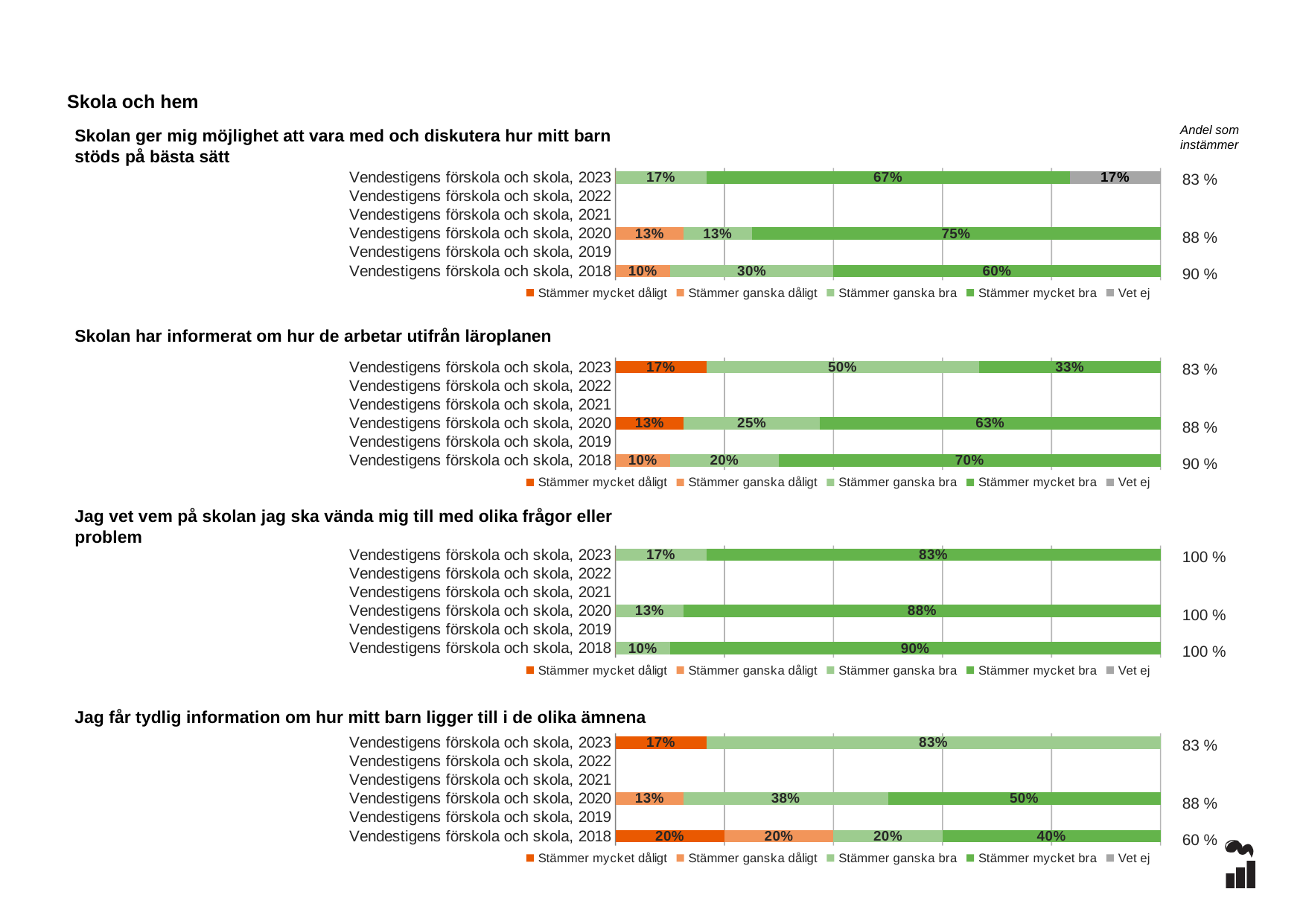
In the chart 'Jag får tydlig information om hur mitt barn ligger till i de olika ämnena', what is the 'Stämmer ganska bra' value for Vendestigens förskola och skola, 2020? 38% In the chart 'Jag vet vem på skolan jag ska vända mig till med olika frågor eller problem', what is the 'Stämmer mycket bra' value for Vendestigens förskola och skola, 2018? 90% In the chart 'Skolan har informerat om hur de arbetar utifrån läroplanen', what is the 'Stämmer ganska bra' value for Vendestigens förskola och skola, 2023? 50% In the chart 'Skolan ger mig möjlighet att vara med och diskutera hur mitt barn stöds på bästa sätt', what is the 'Vet ej' value for Vendestigens förskola och skola, 2023? 17% What kind of chart is used for 'Skolan har informerat om hur de arbetar utifrån läroplanen'? Stacked bar chart In the chart 'Jag får tydlig information om hur mitt barn ligger till i de olika ämnena', which year has the lowest 'Andel som instämmer'? 2018 In the chart 'Skolan ger mig möjlighet att vara med och diskutera hur mitt barn stöds på bästa sätt', what is the 'Stämmer mycket bra' value for Vendestigens förskola och skola, 2020? 75% In the chart 'Jag får tydlig information om hur mitt barn ligger till i de olika ämnena', is the 'Stämmer mycket bra' value for 2020 larger or smaller than the 'Stämmer mycket bra' value for 2018? larger In the chart 'Skolan har informerat om hur de arbetar utifrån läroplanen', which year has the highest 'Stämmer mycket bra' value? 2018 In the chart 'Skolan har informerat om hur de arbetar utifrån läroplanen', what is the difference between the 'Stämmer mycket bra' values for 2018 and 2023? 37% In the chart 'Jag vet vem på skolan jag ska vända mig till med olika frågor eller problem', what is the 'Andel som instämmer' for 2023? 100 % How many series does the legend list for the chart 'Skolan ger mig möjlighet att vara med och diskutera hur mitt barn stöds på bästa sätt'? 5